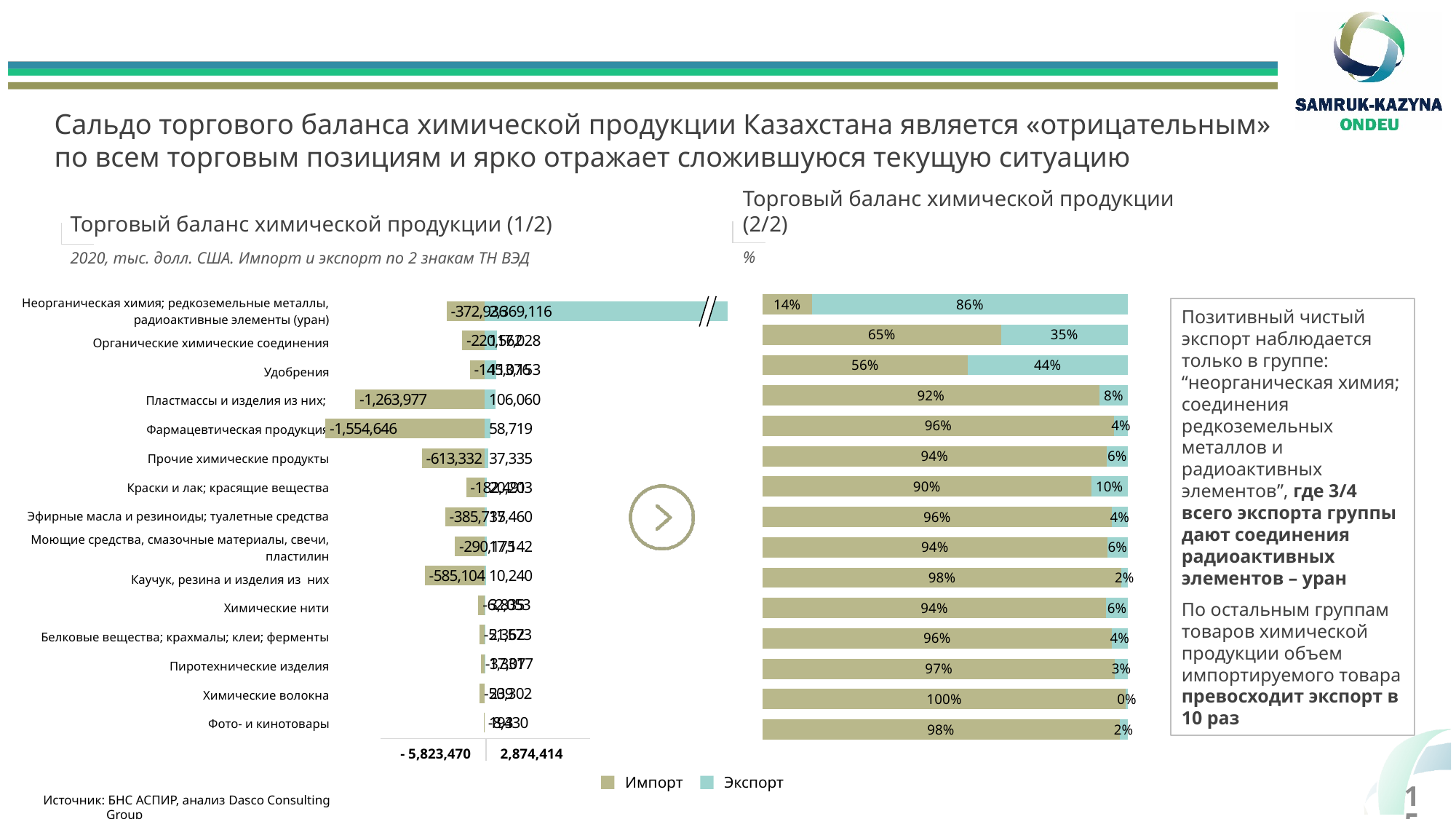
In the chart 'Торговый баланс химической продукции (2/2)', which category has the highest export share? Неорганическая химия; редкоземельные металлы, радиоактивные элементы (уран) In the chart 'Торговый баланс химической продукции (2/2)', which is larger for 'Пластмассы и изделия из них': the import share or the export share? Import share In the chart 'Торговый баланс химической продукции (1/2)', what is the export value for 'Пластмассы и изделия из них'? 106,060 In the chart 'Торговый баланс химической продукции (2/2)', what is the import share for 'Неорганическая химия; редкоземельные металлы, радиоактивные элементы (уран)'? 14% In the chart 'Торговый баланс химической продукции (2/2)', what is the export share for 'Удобрения'? 44% What kind of chart is 'Торговый баланс химической продукции (2/2)'? Stacked bar chart In the chart 'Торговый баланс химической продукции (1/2)', what is the export value for 'Прочие химические продукты'? 37,335 In the chart 'Торговый баланс химической продукции (2/2)', what is the difference between the import share and the export share for 'Органические химические соединения'? 30% In the chart 'Торговый баланс химической продукции (1/2)', what is the import value for 'Фармацевтическая продукция'? -1,554,646 How many series does the legend list for the charts on the slide? 2 In the chart 'Торговый баланс химической продукции (2/2)', which category has the lowest export share? Химические волокна How many categories are shown in the chart 'Торговый баланс химической продукции (1/2)'? 15